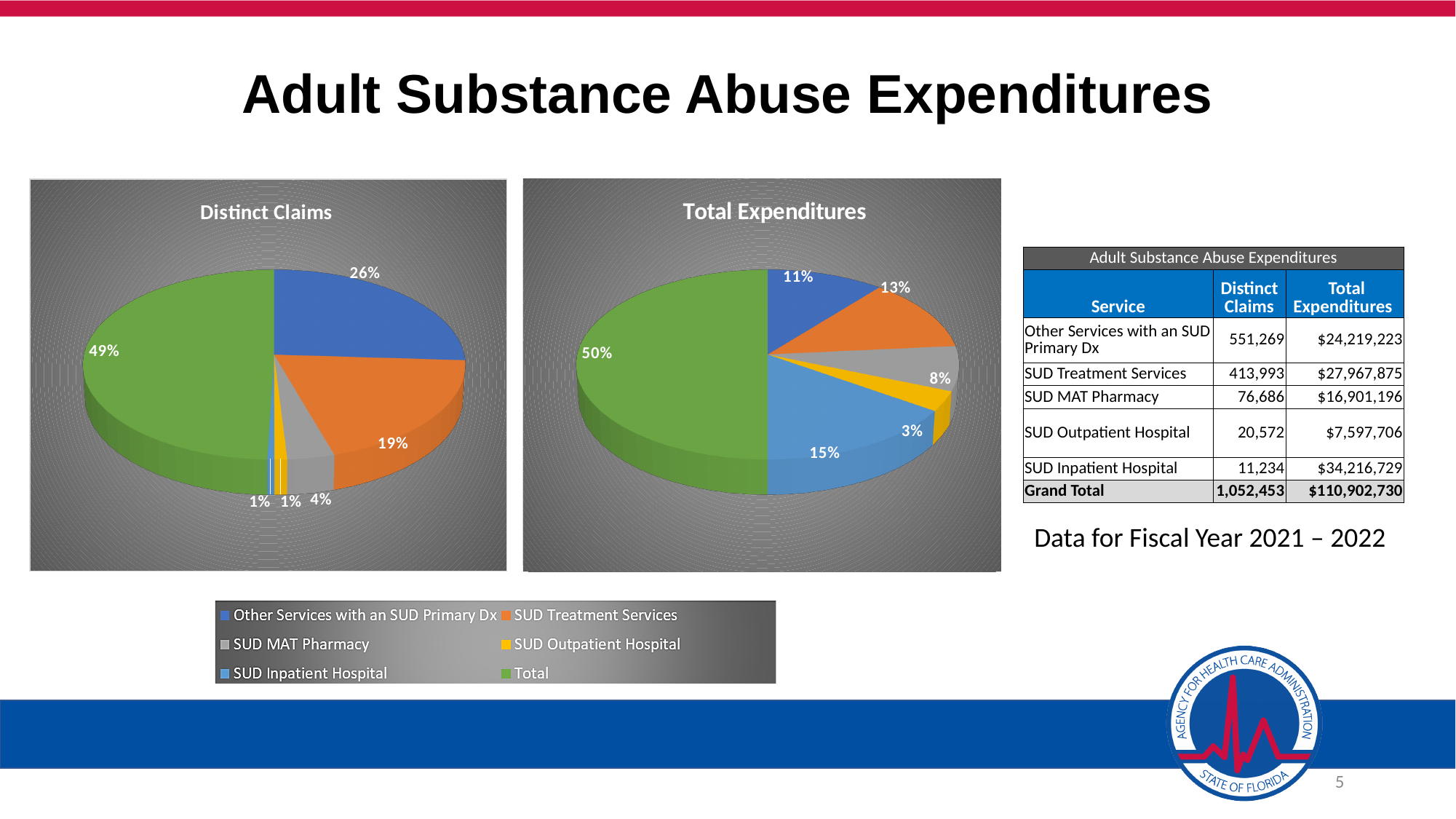
How many entries does the shared legend list for the pie charts? 6 In the "Total Expenditures" chart, what share does SUD MAT Pharmacy have? 8% In the "Total Expenditures" chart, what share does SUD Inpatient Hospital have? 15% In the "Distinct Claims" chart, what share does SUD Treatment Services have? 19% In the "Distinct Claims" chart, what is the difference in percentage points between Other Services with an SUD Primary Dx and SUD Treatment Services? 7 percentage points What colour represents SUD Outpatient Hospital in the pie charts? Yellow In the "Total Expenditures" chart, which is larger, SUD Treatment Services or Other Services with an SUD Primary Dx? SUD Treatment Services What kind of chart is the "Distinct Claims" chart? Pie chart In the "Total Expenditures" chart, which slice is the largest? Total